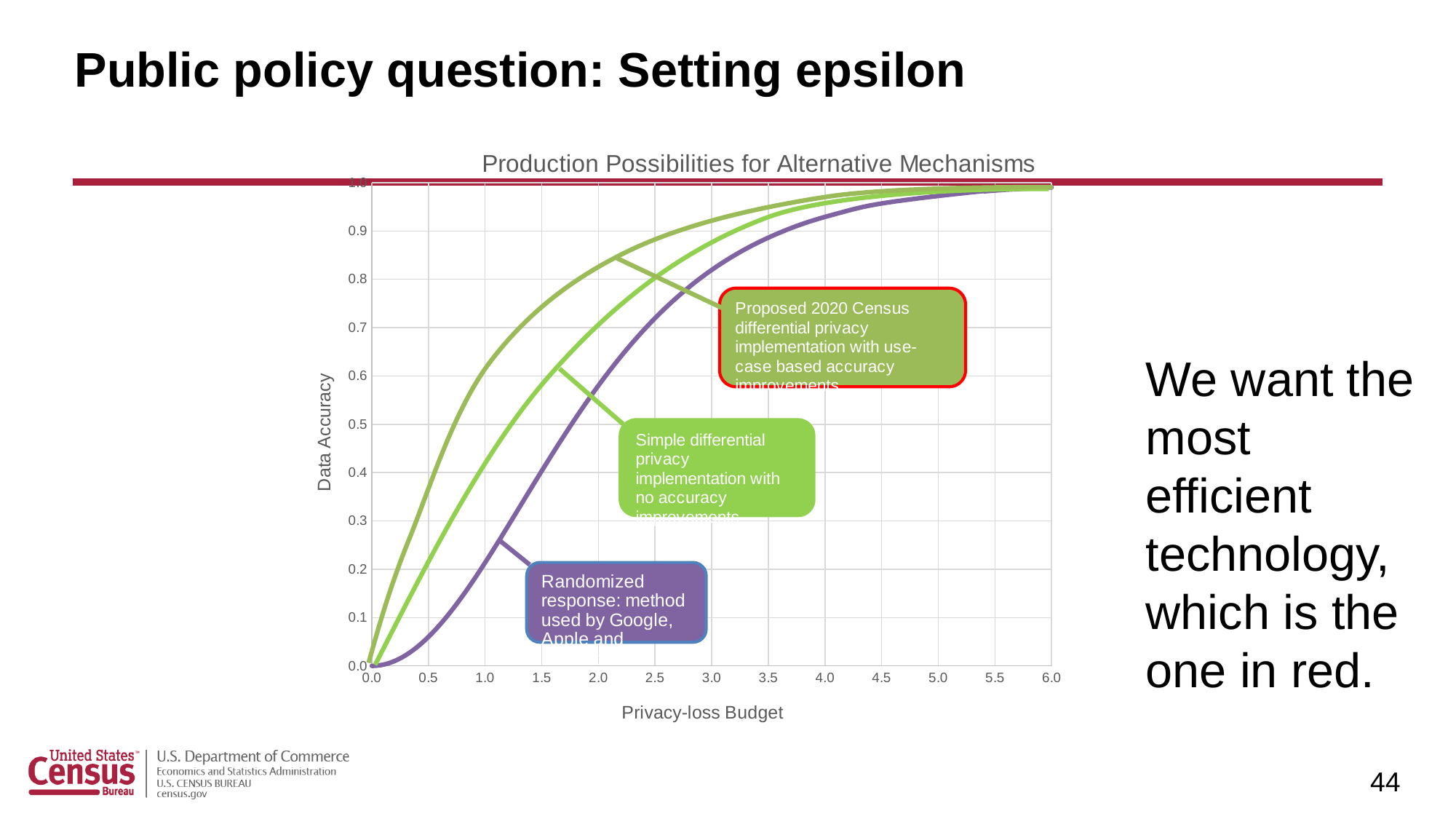
What kind of chart is shown on the slide? line chart What is the label of the x axis of the chart? Privacy-loss Budget Which curve has the lowest data accuracy at a privacy-loss budget of 1.0? Randomized response At a privacy-loss budget of 1.0, is the data accuracy of the 'Proposed 2020 Census differential privacy implementation' curve greater or less than 0.5? greater How many curves are plotted on the chart? 3 At a privacy-loss budget of 1.5, which curve has lower data accuracy: the 'Simple differential privacy implementation' curve or the 'Randomized response' curve? Randomized response At a privacy-loss budget of 5.0, is the data accuracy of the 'Randomized response' curve greater or less than 0.9? greater At a privacy-loss budget of 0.5, is the data accuracy of the 'Randomized response' curve greater or less than 0.1? less Do the curves rise or fall as the privacy-loss budget increases? rise At a privacy-loss budget of 1.0, which curve has higher data accuracy: the 'Proposed 2020 Census differential privacy implementation' curve or the 'Randomized response' curve? Proposed 2020 Census differential privacy implementation What is the title of the chart? Production Possibilities for Alternative Mechanisms